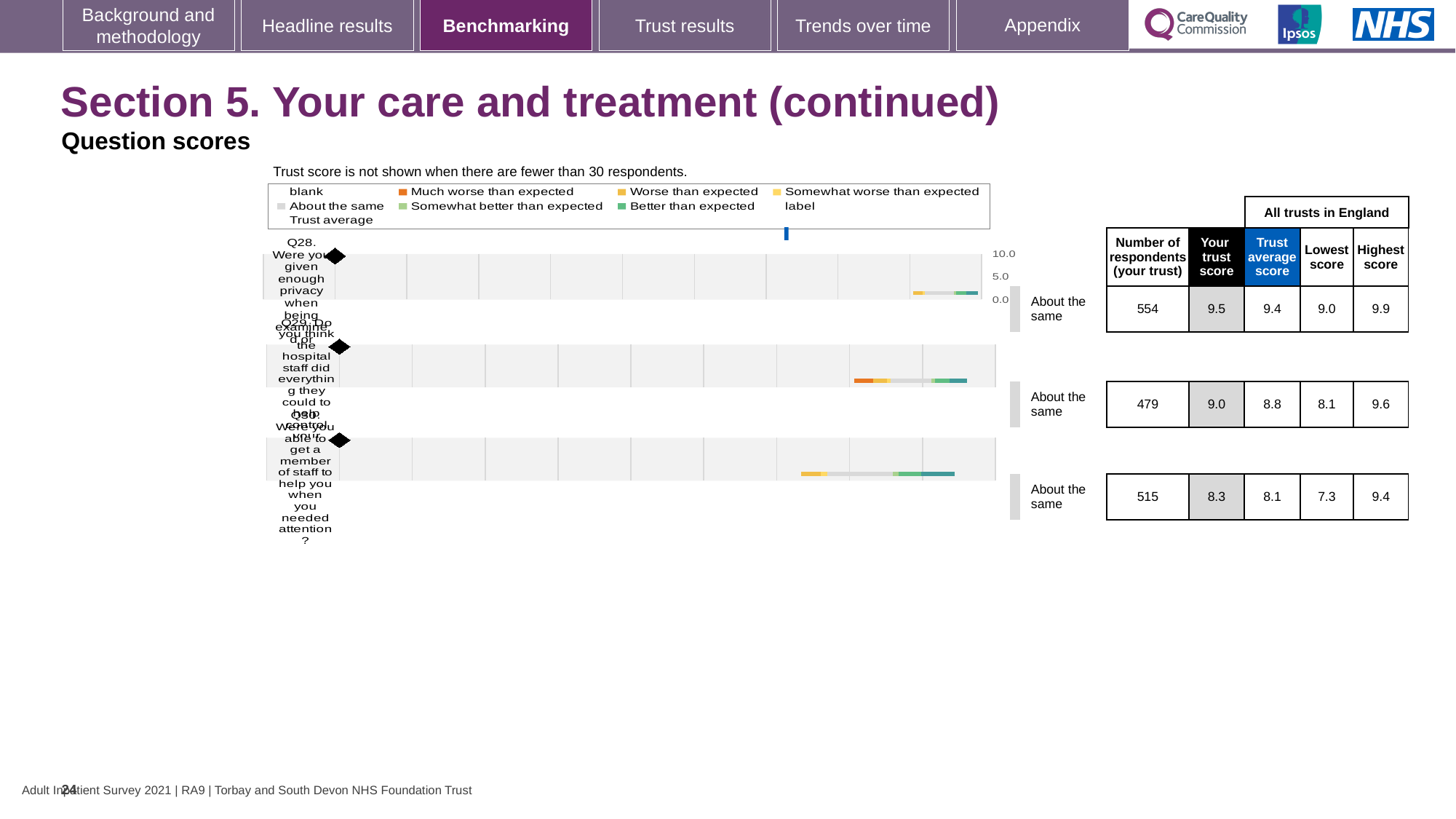
How many questions (Q28, Q29, Q30) are plotted on the slide? 3 What is the trust score for Q28 shown in the table? 9.5 What benchmark category is shown next to the Q28 chart? About the same How many respondents answered Q30 at this trust? 515 Which question has the lowest trust score: Q28, Q29 or Q30? Q30 Which question has the highest trust score: Q28, Q29 or Q30? Q28 What kind of chart is used to show the question scores on this slide? bar chart Is the trust score for Q30 greater or less than 5.0 on the chart axis? greater What is the highest score across all trusts in England for Q30? 9.4 What is the difference between the trust score and the trust average score for Q28? 0.1 Which has the larger trust score, Q29 or Q30? Q29 What is the trust average score for Q29? 8.8